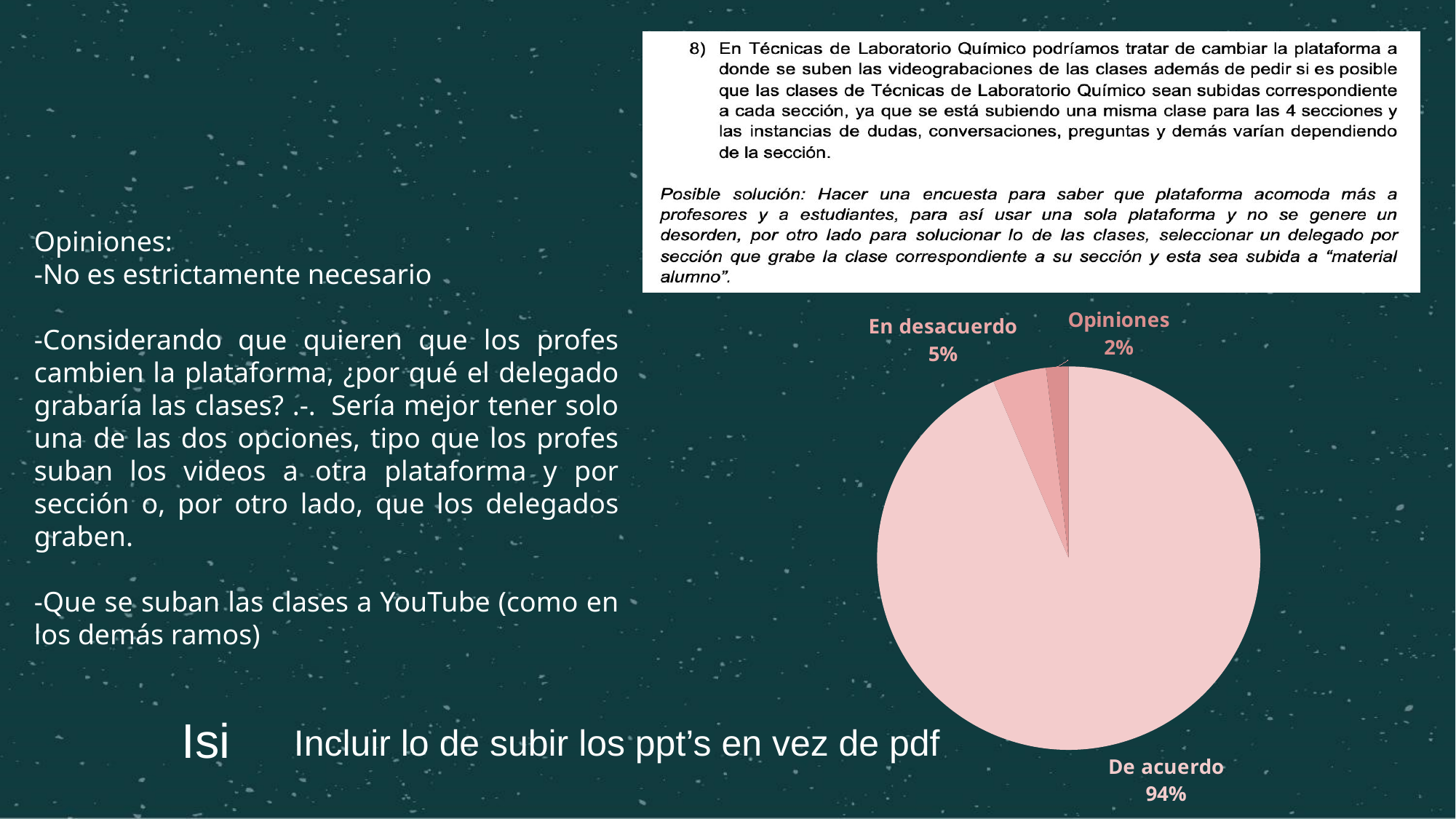
What percentage of the pie chart is labelled "En desacuerdo"? 5% How many slices does the pie chart have? 3 What percentage of the pie chart is labelled "Opiniones"? 2% What kind of chart is shown on the slide? pie chart What percentage of the pie chart is labelled "De acuerdo"? 94% Which slice of the pie chart is the smallest? Opiniones What is the difference in percentage points between the "De acuerdo" and "En desacuerdo" slices? 89 What colour is the "De acuerdo" slice of the pie chart? light pink Which slice of the pie chart is the largest? De acuerdo What is the difference in percentage points between the "En desacuerdo" and "Opiniones" slices? 3 Which slice is larger, "En desacuerdo" or "Opiniones"? En desacuerdo What share of the pie does the "De acuerdo" slice represent? 94%